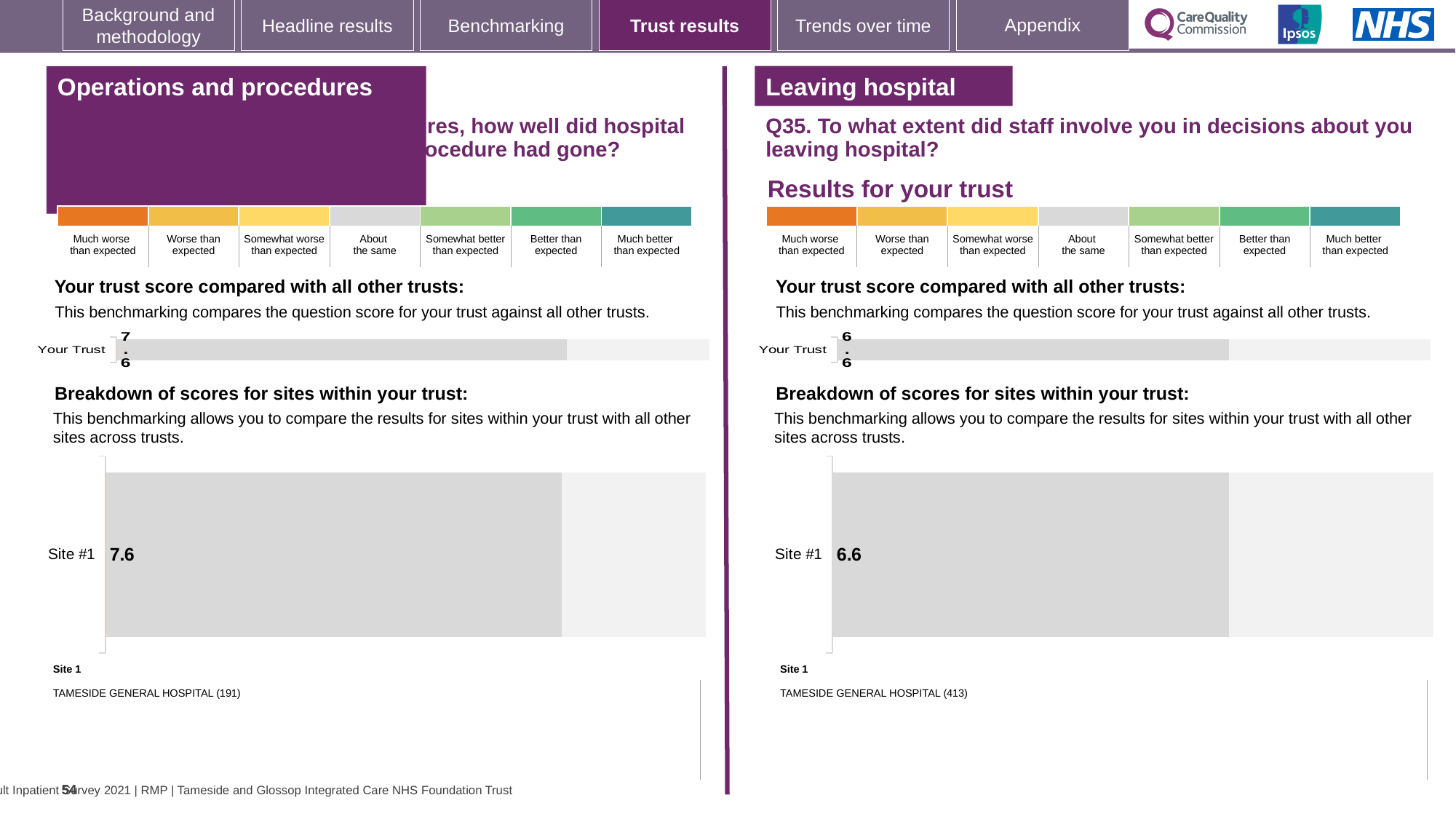
On the left-hand 'Operations and procedures' section, what is the score shown for Your Trust in the 'Your trust score compared with all other trusts' chart? 7.6 How many sites are shown in the 'Breakdown of scores for sites within your trust' chart on the left-hand 'Operations and procedures' section? 1 What type of chart is used for the 'Breakdown of scores for sites within your trust' on the right-hand 'Leaving hospital' section? Bar chart Which site name is listed as Site 1 beneath the breakdown chart on the left-hand 'Operations and procedures' section? TAMESIDE GENERAL HOSPITAL (191) What type of chart is used for the 'Your trust score compared with all other trusts' on the left-hand 'Operations and procedures' section? Bar chart In the 'Breakdown of scores for sites within your trust' chart on the right-hand 'Leaving hospital' section, what is the value for Site #1? 6.6 Which is larger: the Site #1 score in the 'Operations and procedures' breakdown chart or the Site #1 score in the 'Leaving hospital' breakdown chart? Operations and procedures Which site name is listed as Site 1 beneath the breakdown chart on the right-hand 'Leaving hospital' section? TAMESIDE GENERAL HOSPITAL (413) How many sites are shown in the 'Breakdown of scores for sites within your trust' chart on the right-hand 'Leaving hospital' section? 1 What is the difference between the Site #1 score in the 'Operations and procedures' breakdown chart and the Site #1 score in the 'Leaving hospital' breakdown chart? 1.0 In the 'Breakdown of scores for sites within your trust' chart on the left-hand 'Operations and procedures' section, what is the value for Site #1? 7.6 On the right-hand 'Leaving hospital' section, what is the score shown for Your Trust in the 'Your trust score compared with all other trusts' chart? 6.6